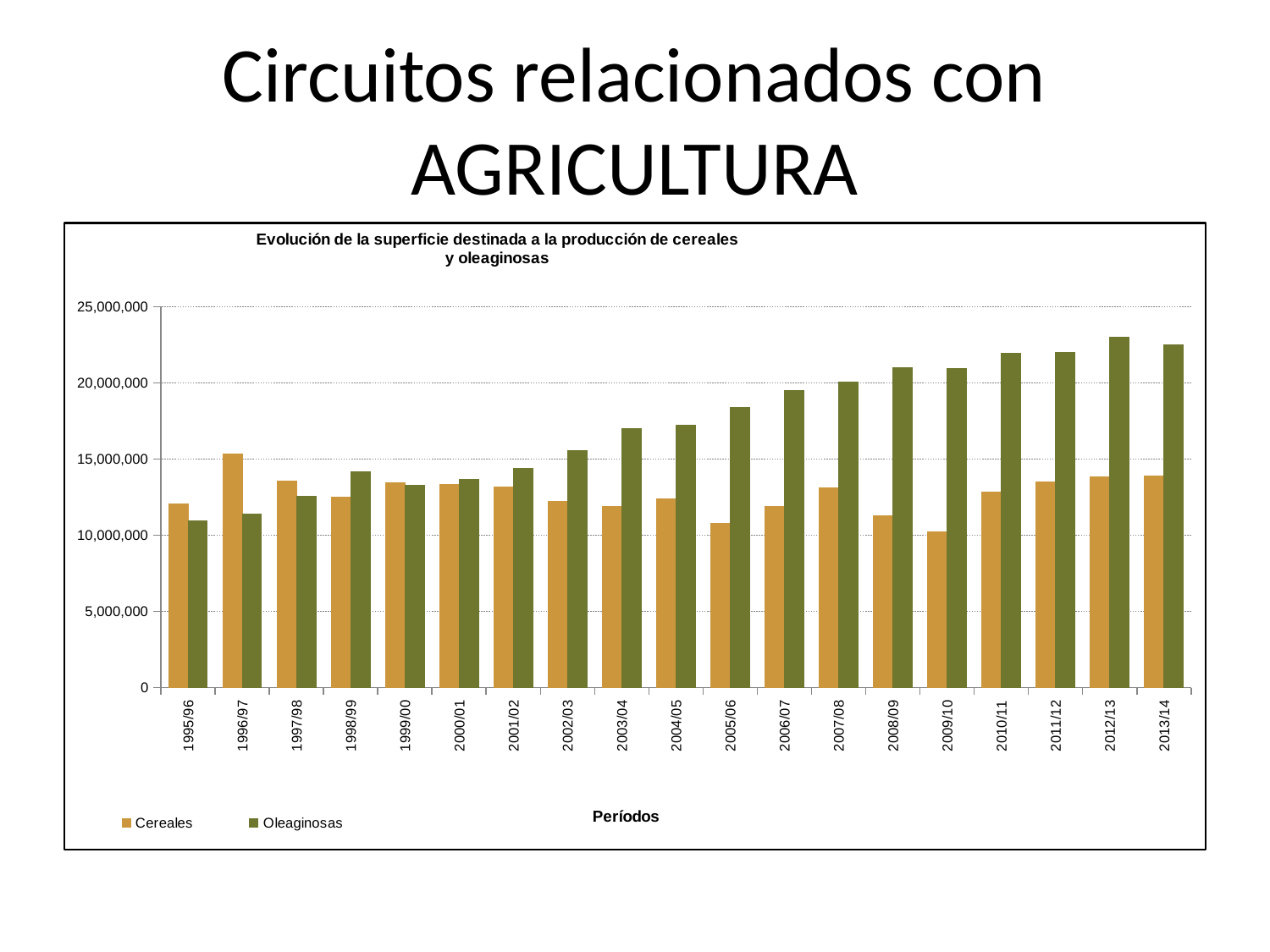
How many periods are shown on the x axis? 19 Is the Oleaginosas value for 2013/14 greater or less than 20,000,000? greater What kind of chart is shown on the slide? bar chart In which period is the Cereales value highest? 1996/97 Is the Cereales value for 1996/97 greater or less than 15,000,000? greater Which series has the larger value in 1995/96, Cereales or Oleaginosas? Cereales Do the Oleaginosas values generally rise or fall from 1995/96 to 2013/14? rise What is the label of the x axis? Períodos Which series has the larger value in 2013/14, Cereales or Oleaginosas? Oleaginosas How many series does the legend list? 2 In which period is the Cereales value lowest? 2009/10 Is the Oleaginosas value for 1995/96 greater or less than 15,000,000? less